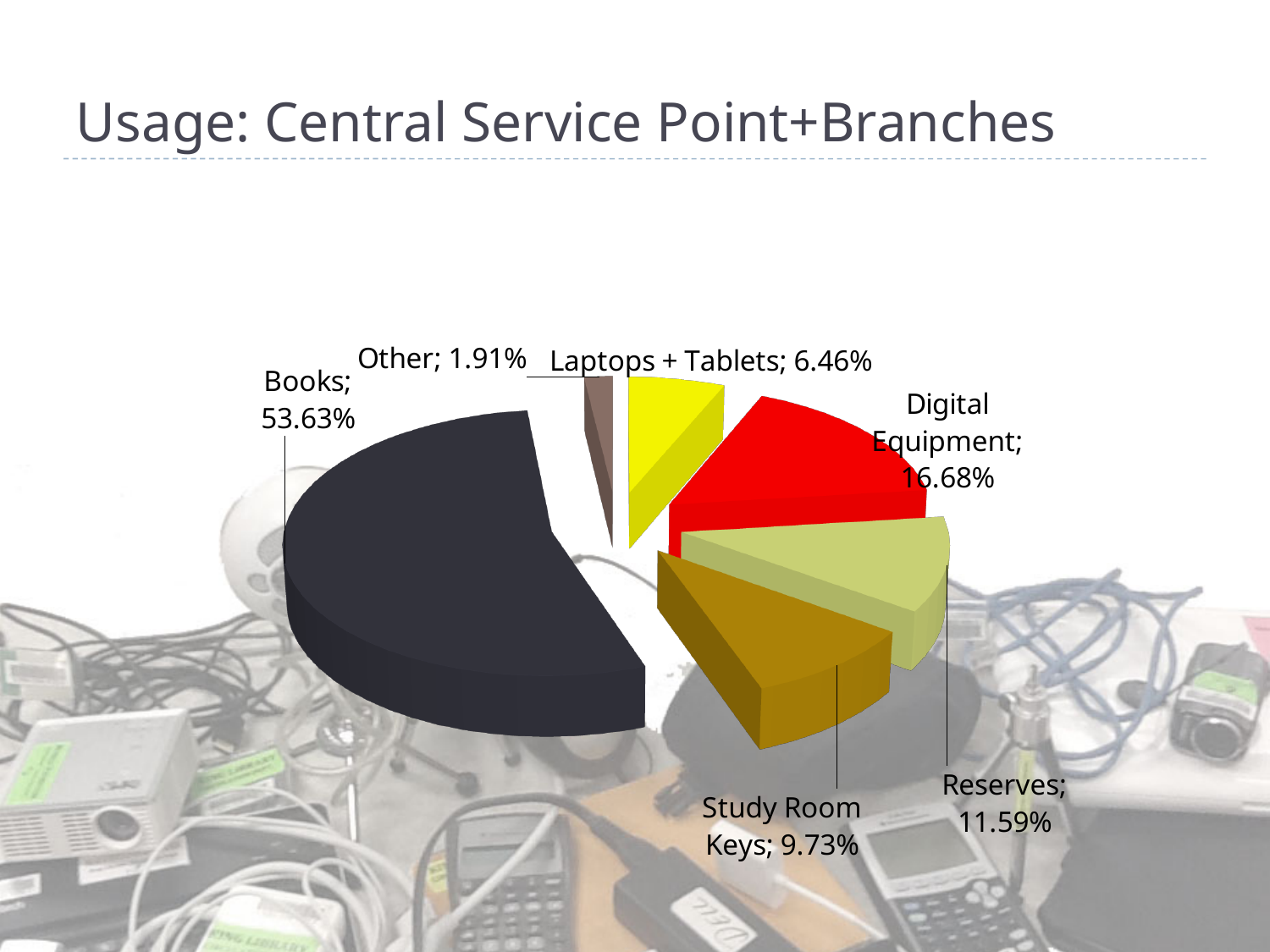
Which category has the largest share of the pie? Books What kind of chart is shown on the slide? Pie chart What share of usage is Laptops + Tablets? 6.46% Which category has the smallest share of the pie? Other How many categories are shown in the pie chart? 6 What share of usage is Digital Equipment? 16.68% What share of usage is Books? 53.63% What share of usage is Study Room Keys? 9.73% Which is larger, the share for Reserves or the share for Study Room Keys? Reserves What share of usage is Reserves? 11.59% What is the difference in percentage points between Digital Equipment and Laptops + Tablets? 10.22 What is the title of the slide containing the chart? Usage: Central Service Point+Branches